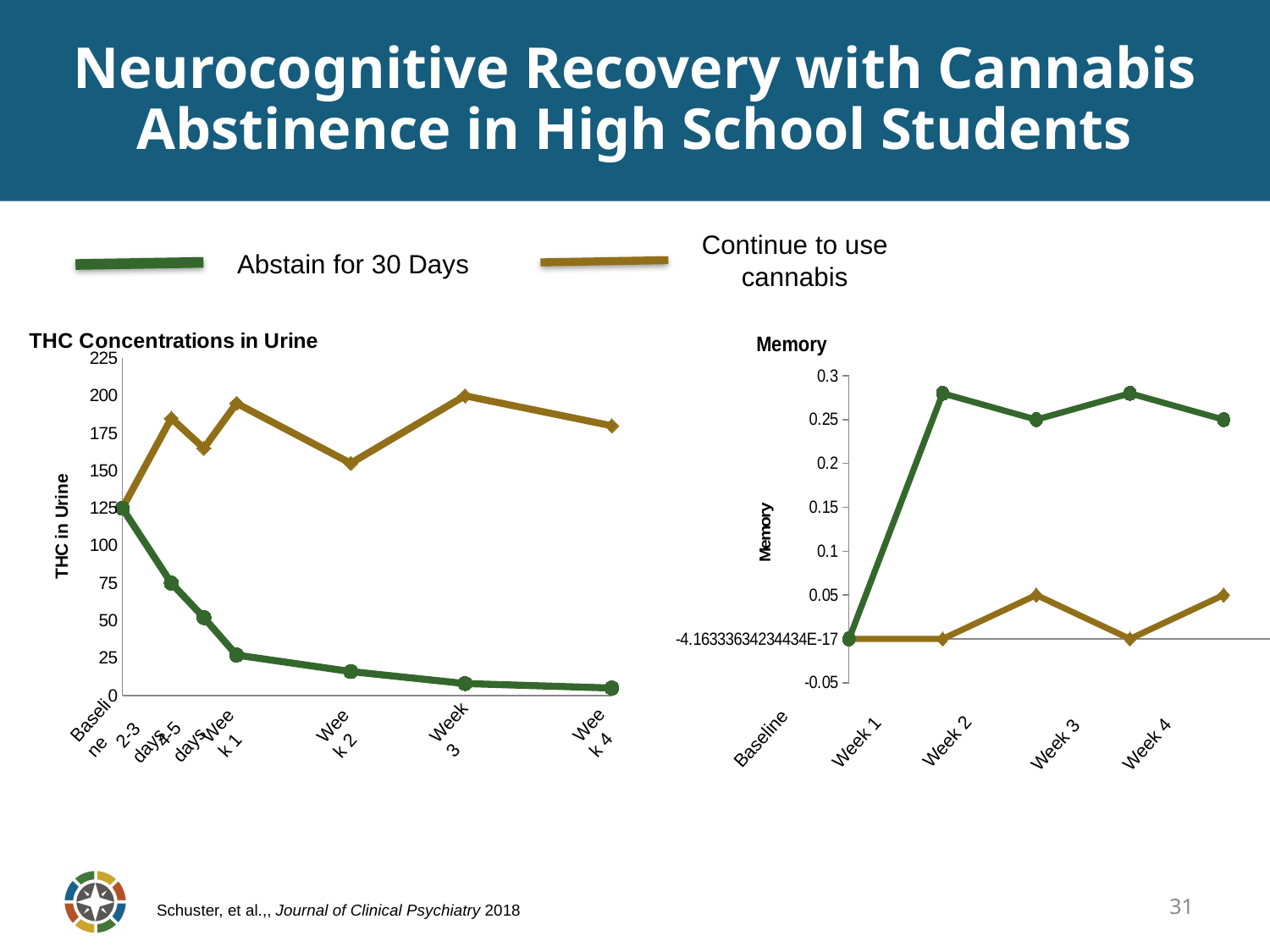
In the Memory chart, which series has the higher value at Week 4? Abstain for 30 Days How many time points are plotted on the x axis of the Memory chart? 5 What is the y-axis title of the THC Concentrations in Urine chart? THC in Urine In the THC Concentrations in Urine chart, is the value for Abstain for 30 Days at Week 4 greater or less than 25? less In the THC Concentrations in Urine chart, does the Abstain for 30 Days line rise or fall from Baseline to Week 4? fall In the THC Concentrations in Urine chart, is the value for Continue to use cannabis at Week 3 greater or less than 175? greater How many series does the legend at the top of the slide list? 2 In the Memory chart, is the value for Abstain for 30 Days at Week 1 greater or less than 0.2? greater What kind of chart is the THC Concentrations in Urine chart? line chart In the THC Concentrations in Urine chart, which series has the higher value at Week 2? Continue to use cannabis How many time points are plotted on the x axis of the THC Concentrations in Urine chart? 7 In the THC Concentrations in Urine chart, at which time point is the Abstain for 30 Days series highest? Baseline